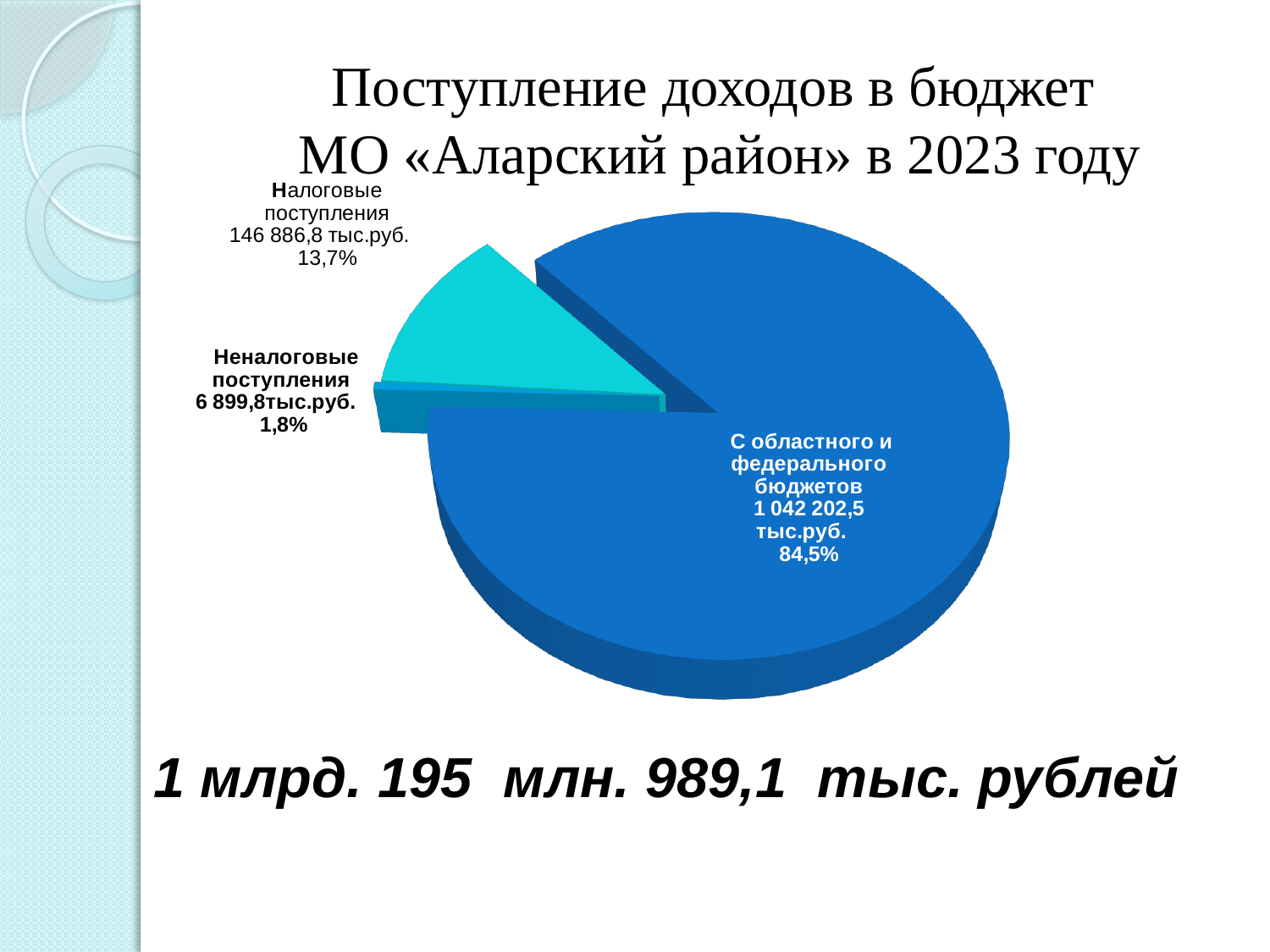
What share of the pie does «С областного и федерального бюджетов» represent? 84,5% What share of the pie does «Налоговые поступления» represent? 13,7% By how many percentage points does the share of «Налоговые поступления» exceed the share of «Неналоговые поступления»? 11,9 What is the value shown for «Налоговые поступления»? 146 886,8 тыс.руб. What kind of chart is shown on the slide? Pie chart Which slice of the pie chart is the largest? С областного и федерального бюджетов What is the value shown for «Неналоговые поступления»? 6 899,8 тыс.руб. How many slices does the pie chart have? 3 What share of the pie does «Неналоговые поступления» represent? 1,8% What is the value shown for «С областного и федерального бюджетов»? 1 042 202,5 тыс.руб. Which is larger: «Налоговые поступления» or «Неналоговые поступления»? Налоговые поступления Which slice of the pie chart is the smallest? Неналоговые поступления